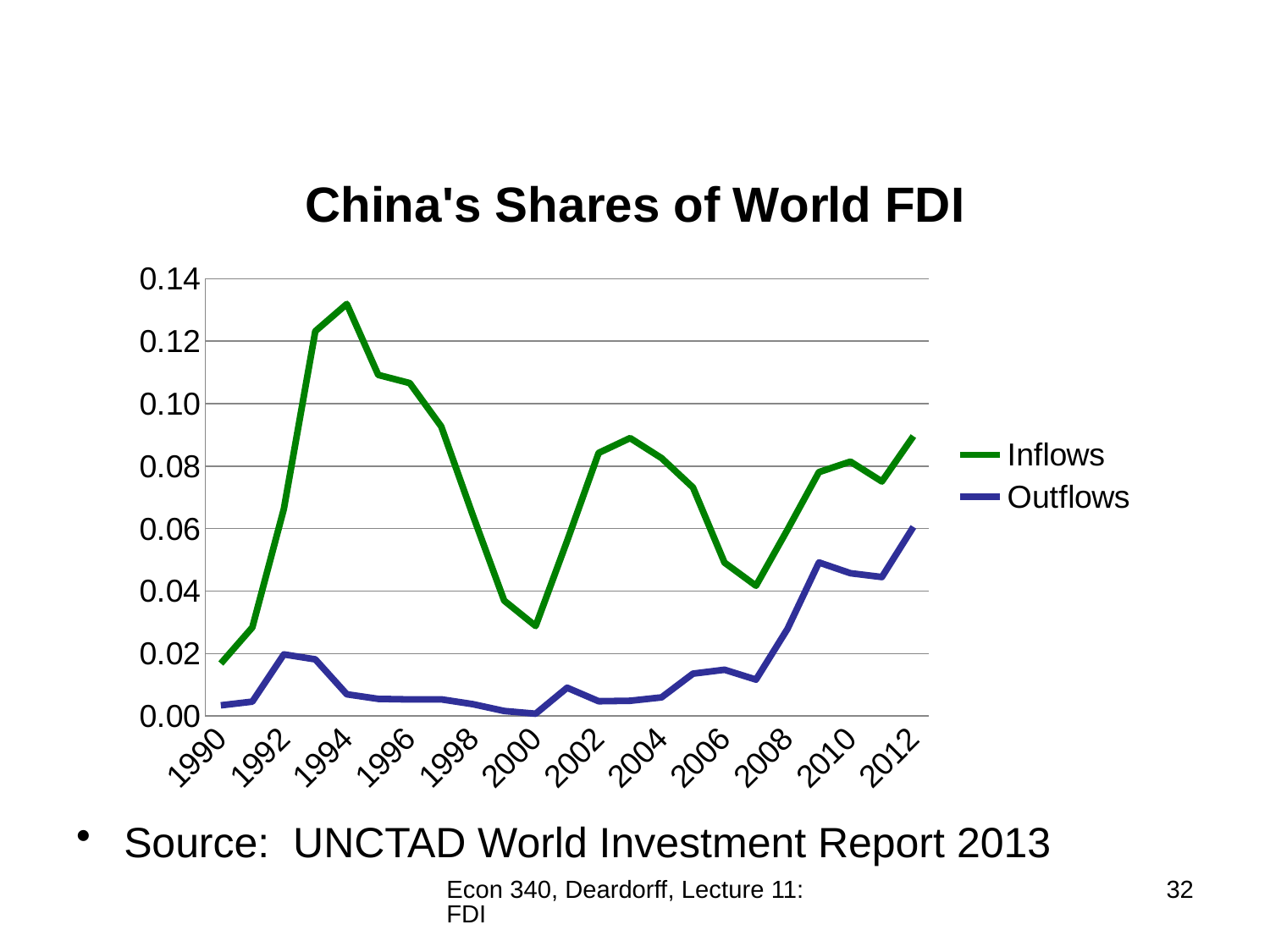
In which year does the Inflows line reach its highest value? 1994 In which year does the Outflows line reach its highest value? 2012 What kind of chart is shown on the slide? line chart Is the value for Outflows in 2012 greater or less than 0.04? greater Is the value for Outflows in 1990 greater or less than 0.02? less How many series does the legend list? 2 In 2004, which series has the larger value, Inflows or Outflows? Inflows Is the value for Inflows in 2000 greater or less than 0.04? less What is the title of the chart? China's Shares of World FDI Which colour is used for the Outflows line? blue Do the Inflows values rise or fall between 1994 and 2000? fall